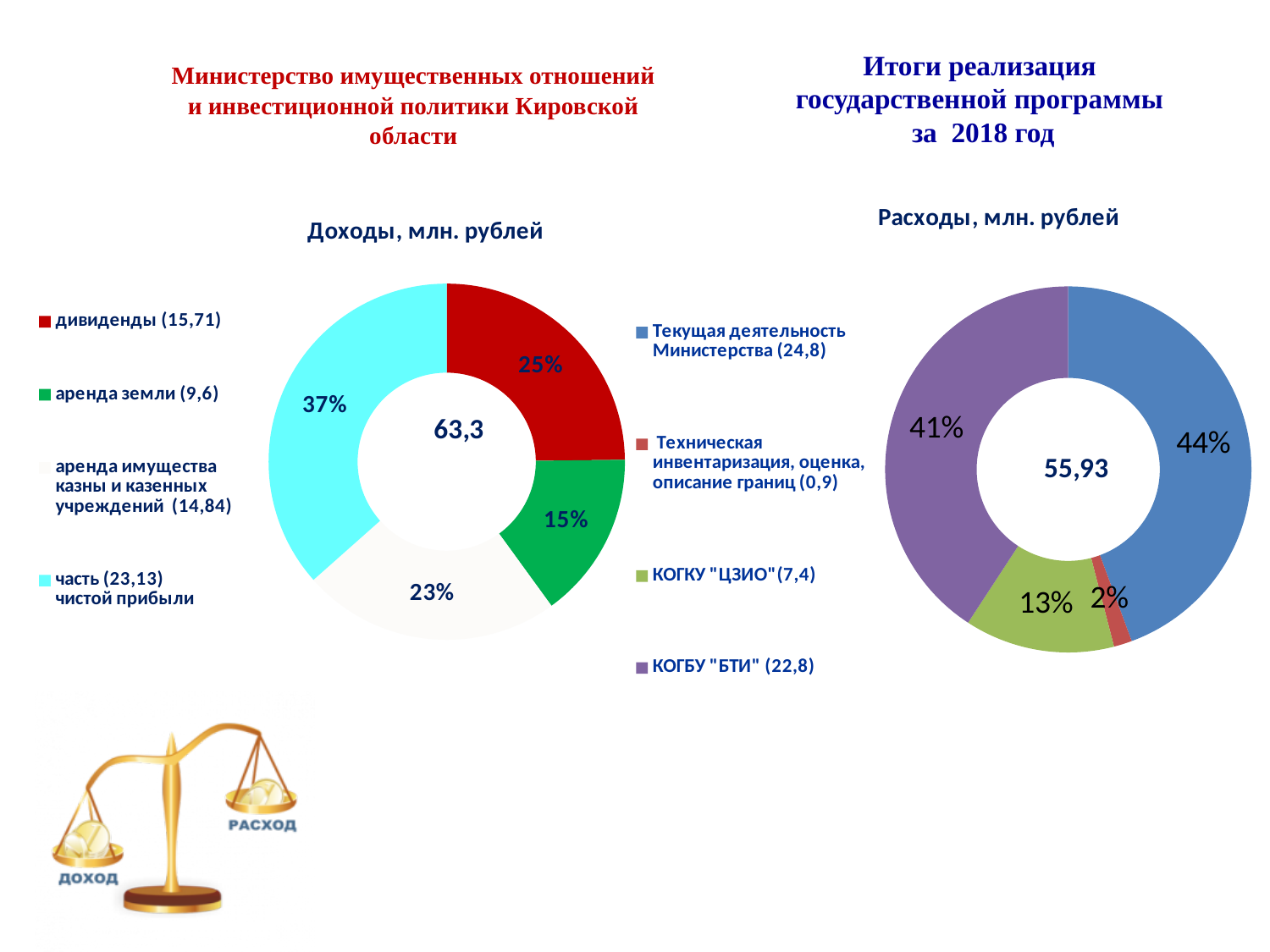
In the "Доходы, млн. рублей" chart, what total value is shown in the centre of the doughnut? 63,3 How many categories does the legend of the "Расходы, млн. рублей" chart list? 4 In the "Расходы, млн. рублей" chart, what is the difference in percentage points between the shares of "Текущая деятельность Министерства" and "КОГКУ "ЦЗИО""? 31 percentage points What type of chart is the "Доходы, млн. рублей" chart? Doughnut (pie) chart In the "Доходы, млн. рублей" chart, what share of the pie is labelled for "дивиденды"? 25% In the "Доходы, млн. рублей" chart, which category has the smallest share? аренда земли In the "Доходы, млн. рублей" chart, what share of the pie is labelled for "часть чистой прибыли"? 37% In the "Расходы, млн. рублей" chart, which category has the smallest share? Техническая инвентаризация, оценка, описание границ In the "Доходы, млн. рублей" chart, which category has the largest share? часть чистой прибыли In the "Расходы, млн. рублей" chart, what share of the pie is labelled for "Текущая деятельность Министерства"? 44% In the "Доходы, млн. рублей" chart, what value is shown in the legend for "аренда земли"? 9,6 In the "Расходы, млн. рублей" chart, what value is shown in the legend for "КОГБУ "БТИ""? 22,8